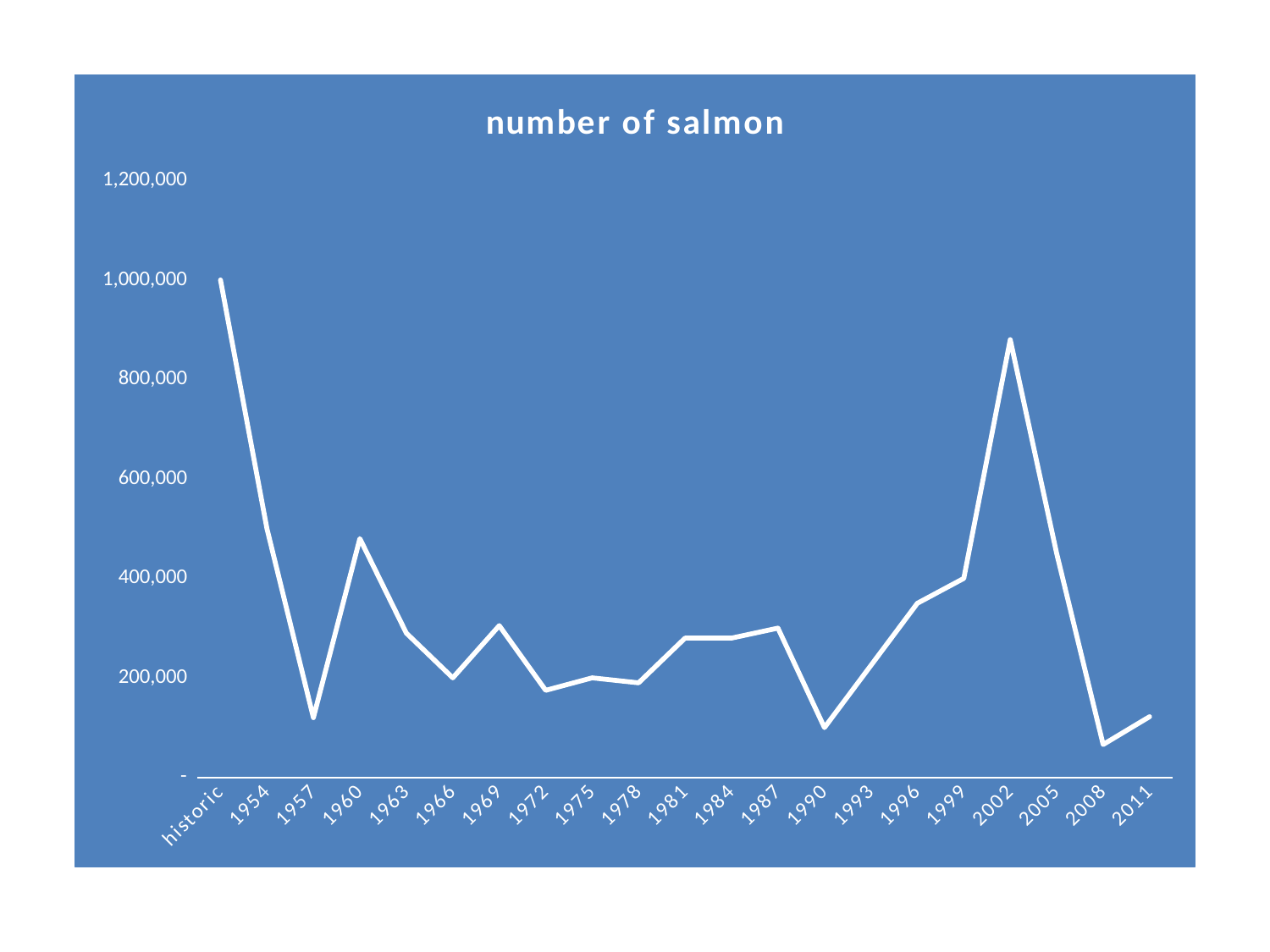
Which year has the lowest number of salmon? 2008 Is the value for 1990 greater or less than 200,000? less Which is larger, the value for 1957 or the value for 1960? 1960 Is the value for 1981 greater or less than 200,000? greater Which is larger, the value for 2008 or the value for 2011? 2011 How many points are plotted along the x axis of the chart? 21 Is the value for 2002 greater or less than 800,000? greater Which category has the highest number of salmon? historic What kind of chart is shown on the slide? line chart Do the values rise or fall from 1990 to 2002? rise What is the title of the chart? number of salmon